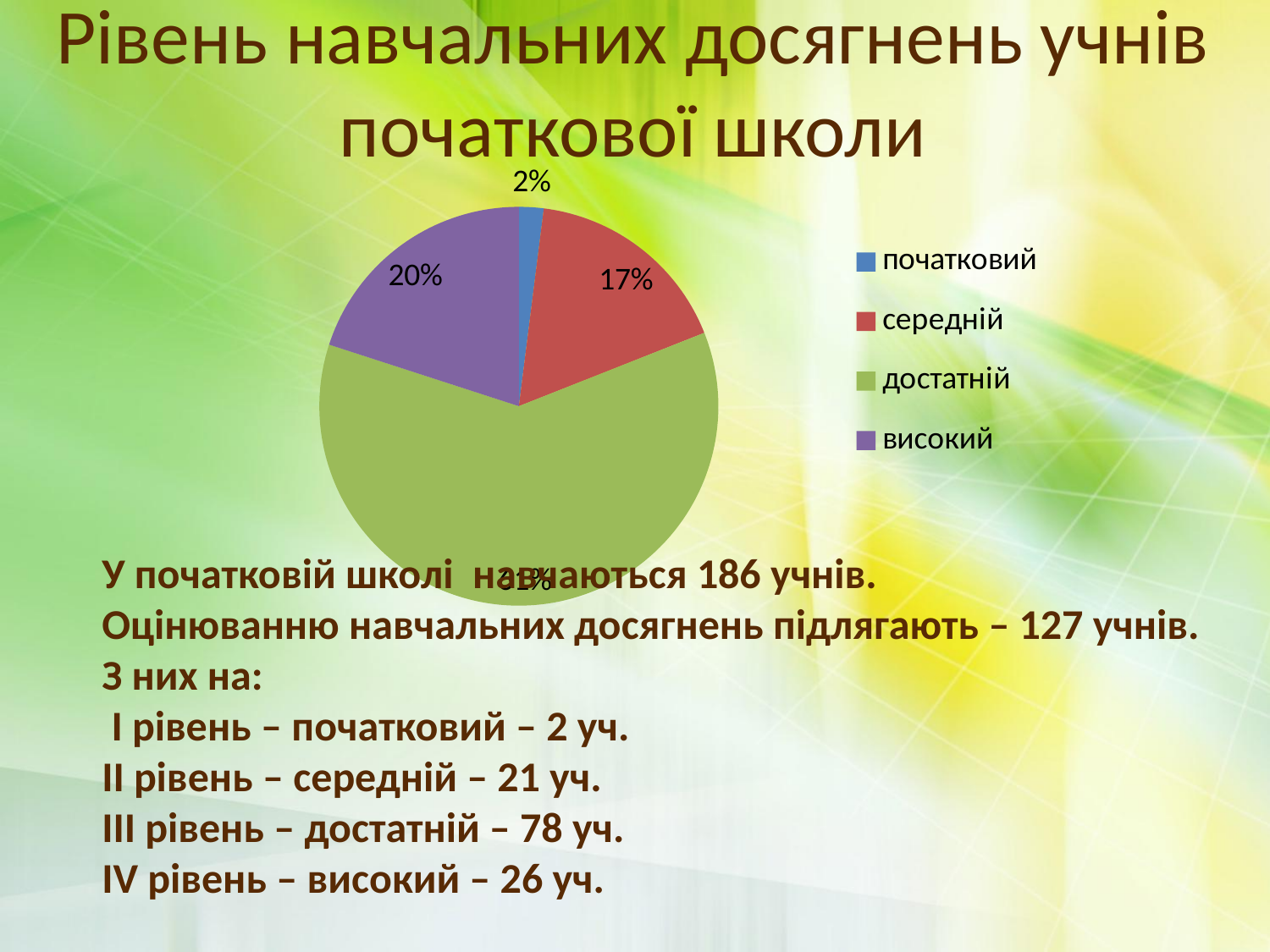
What is the difference in percentage points between the високий and середній slices? 3% What kind of chart is shown on the slide? pie chart What colour is the slice for достатній? green What share of the pie is labelled for середній? 17% Which category has the smallest slice of the pie? початковий What is the difference in percentage points between the середній and початковий slices? 15% How many entries does the legend list? 4 Which slice is larger, високий or середній? високий What share of the pie is labelled for початковий? 2% How many slices does the pie chart have? 4 Which category has the largest slice of the pie? достатній What share of the pie is labelled for високий? 20%